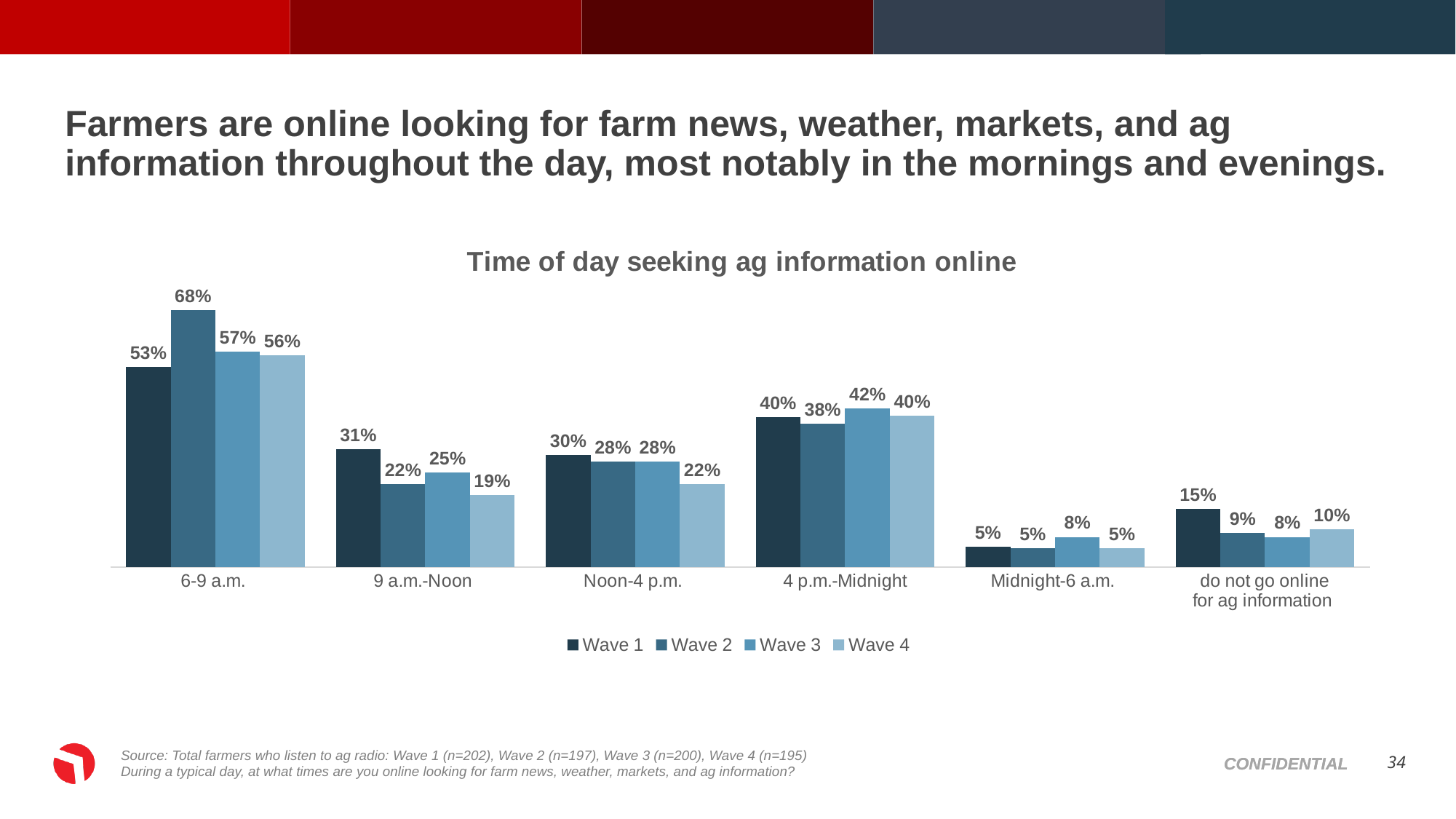
What is the title of the chart? Time of day seeking ag information online What kind of chart is shown on the slide? Bar chart What is the Wave 3 value for 4 p.m.-Midnight? 42% What is the Wave 2 value for 6-9 a.m.? 68% What is the Wave 1 value for 'do not go online for ag information'? 15% What is the Wave 4 value for 9 a.m.-Noon? 19% Which is larger for Noon-4 p.m.: the Wave 1 value or the Wave 4 value? Wave 1 How many series does the legend list? 4 Which time-of-day category has the highest Wave 1 value? 6-9 a.m. How many time-of-day categories are shown on the x axis? 6 What is the difference between the Wave 2 and Wave 1 values for 6-9 a.m.? 15 percentage points